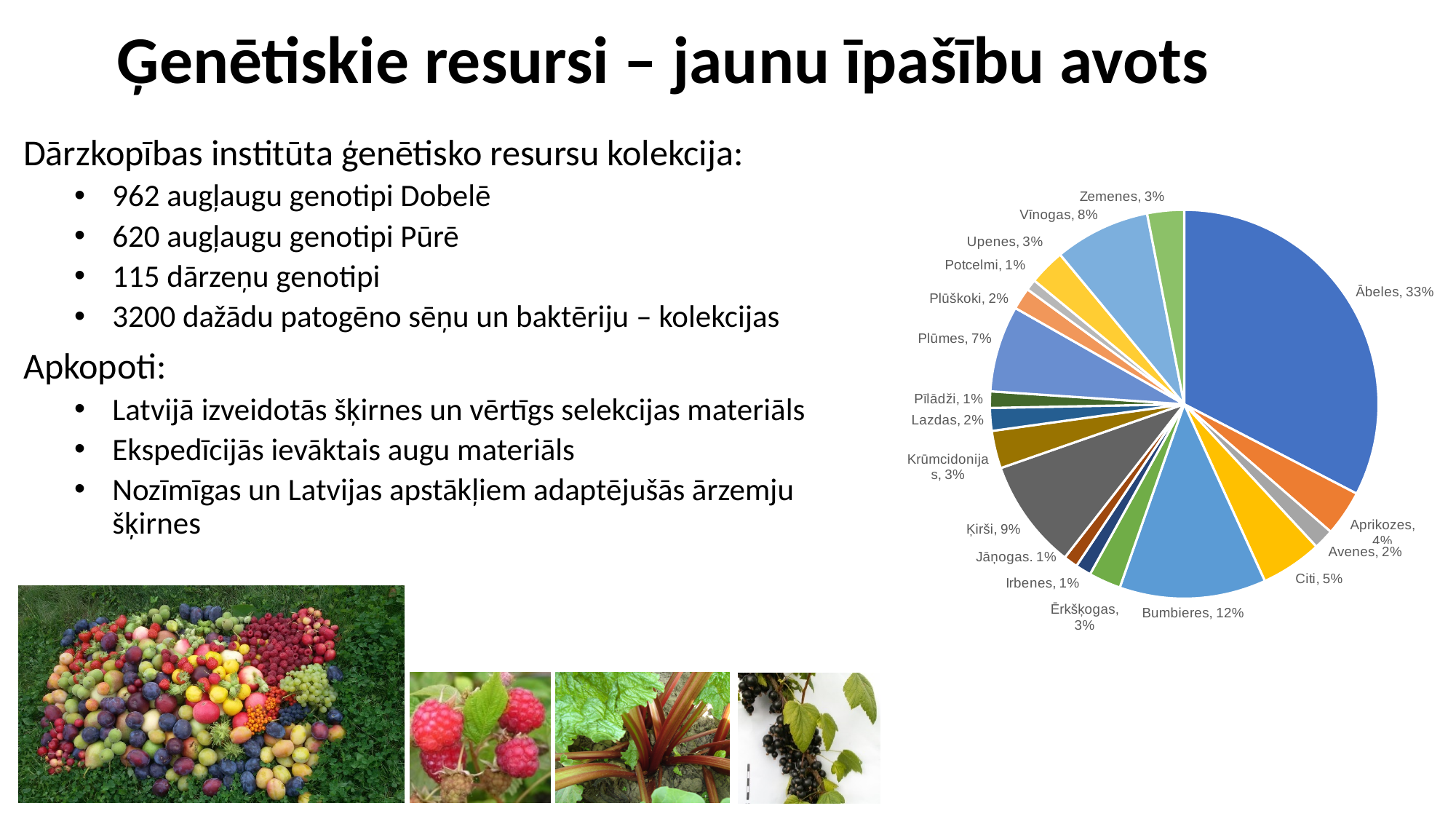
What share of the pie chart does Plūmes have? 7% What share of the pie chart does Citi have? 5% Which category has the largest slice of the pie chart? Ābeles What share of the pie chart does Bumbieres have? 12% What share of the pie chart does Ābeles have? 33% What kind of chart is shown on the slide? pie chart What share of the pie chart does Vīnogas have? 8% What share of the pie chart does Ķirši have? 9% What is the difference in percentage points between Ābeles and Bumbieres in the pie chart? 21 How many slices does the pie chart have? 18 Which is larger in the pie chart, Bumbieres or Ķirši? Bumbieres Which is larger in the pie chart, Vīnogas or Plūmes? Vīnogas